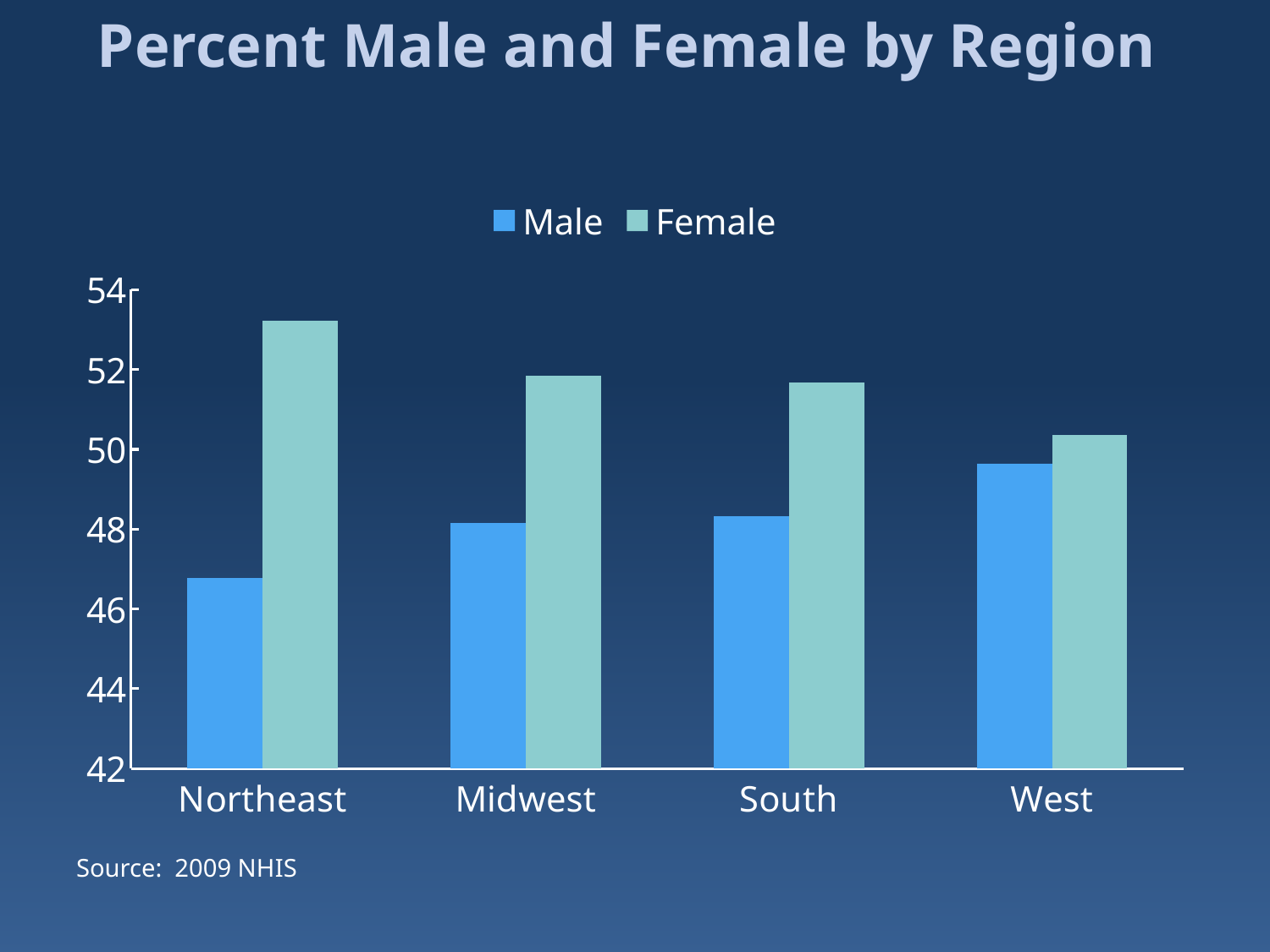
Which region has the highest Female value? Northeast Is the Female value for Northeast greater or less than 52? greater In the West, which is larger, the Male value or the Female value? Female Which region has the lowest Male value? Northeast How many series does the legend list? 2 Which region has the lowest Female value? West What kind of chart is shown on the slide? bar chart How many regions are shown on the x axis? 4 Which region has the highest Male value? West Do the Male values rise or fall from Northeast to West along the x axis? rise Is the Male value for West greater or less than 50? less Is the Male value for Northeast greater or less than 48? less